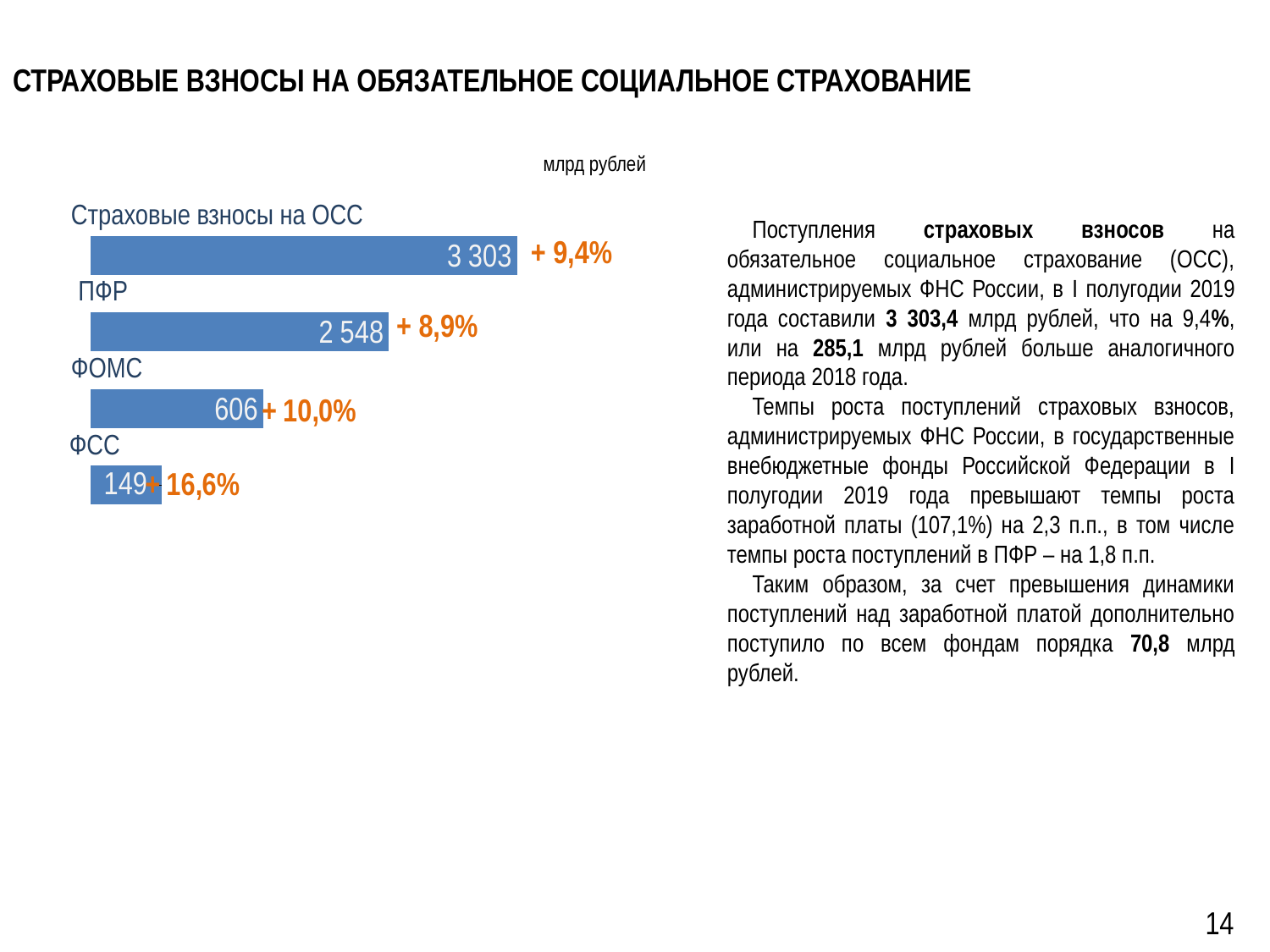
Which category has the highest value on the chart? Страховые взносы на ОСС What is the value shown for ФСС on the chart? 149 What growth percentage is shown next to the ПФР bar? + 8,9% Which is larger, the value for ФОМС or the value for ФСС? ФОМС What is the value shown for Страховые взносы на ОСС on the chart? 3 303 What is the value shown for ФОМС on the chart? 606 What type of chart is shown on the slide? Bar chart What is the difference between the values for ПФР and ФОМС? 1 942 What growth percentage is shown next to the ФСС bar? + 16,6% What is the value shown for ПФР on the chart? 2 548 How many bars are shown on the chart? 4 Which category has the lowest value on the chart? ФСС